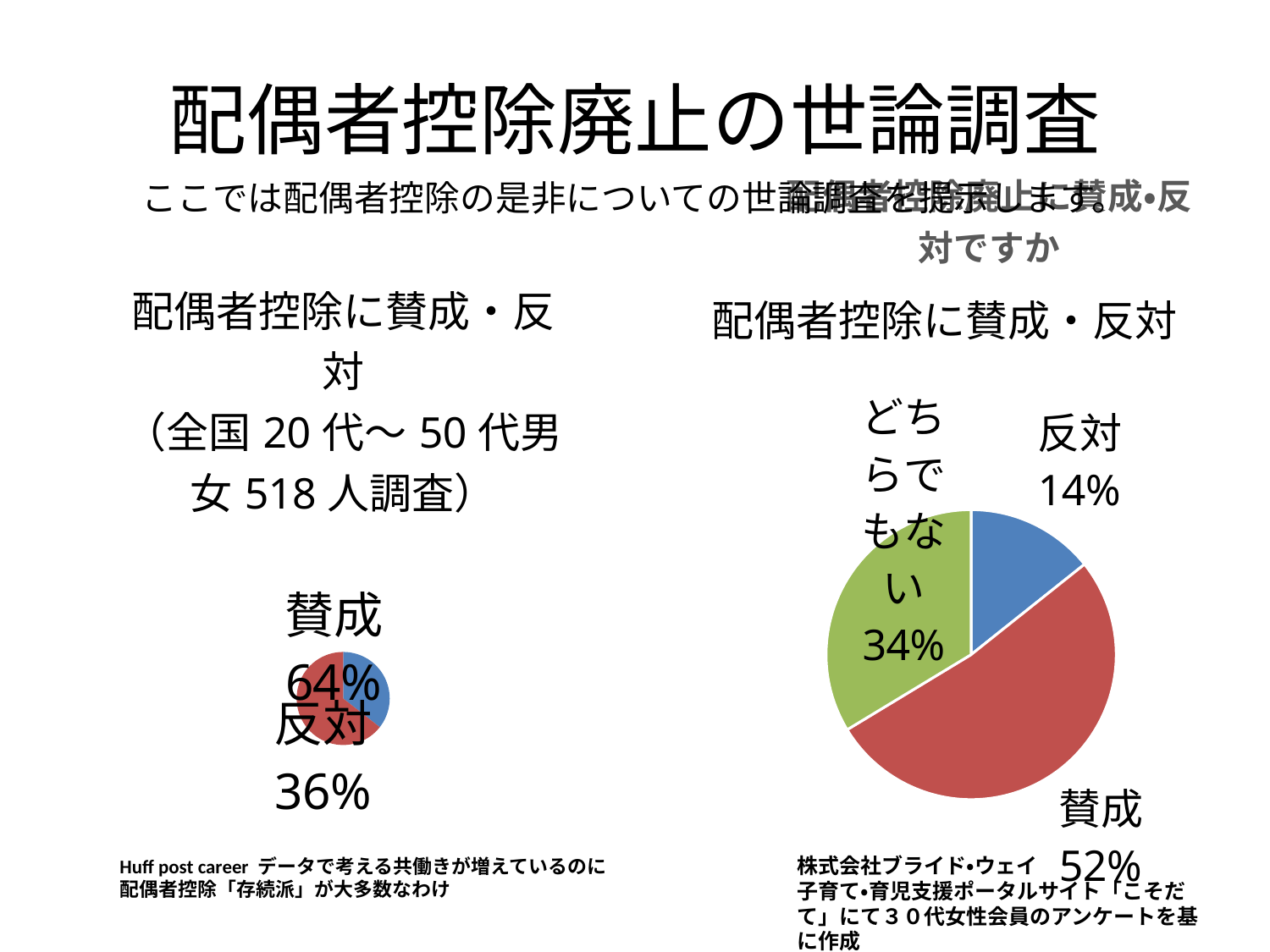
On the left pie chart, what percentage is shown for 賛成? 64% On the right pie chart, what is the difference in percentage points between 賛成 and どちらでもない? 18 On the right pie chart, which category has the largest share? 賛成 On the left pie chart, what percentage is shown for 反対? 36% On the right pie chart, which is larger, 反対 or どちらでもない? どちらでもない On the right pie chart, what percentage is shown for 賛成? 52% On the right pie chart, what percentage is shown for どちらでもない? 34% On the right pie chart, which category has the smallest share? 反対 On the right pie chart, what percentage is shown for 反対? 14% How many slices does the right pie chart have? 3 What type of chart is the left chart? Pie chart On the left pie chart, what is the difference in percentage points between 賛成 and 反対? 28